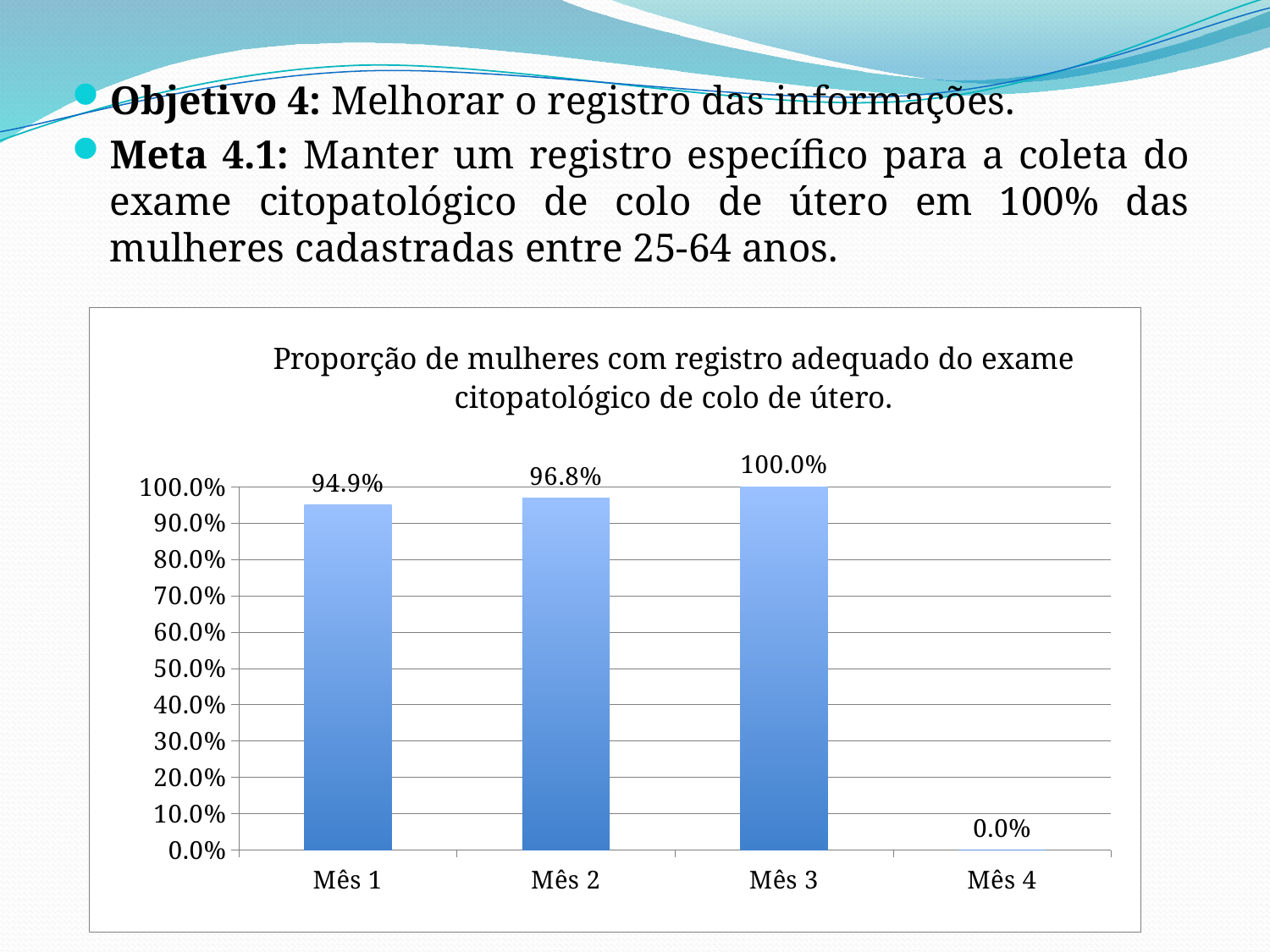
What is the difference between the values for Mês 2 and Mês 1? 1.9% What is the value for Mês 3? 100.0% What is the value for Mês 2? 96.8% Is the value for Mês 1 greater or less than 90.0%? greater Which month has the highest value? Mês 3 What is the title of the chart? Proporção de mulheres com registro adequado do exame citopatológico de colo de útero. Which month has the lowest value? Mês 4 What kind of chart is shown? bar chart Which is larger, the value for Mês 1 or the value for Mês 2? Mês 2 What is the value for Mês 4? 0.0% How many months are shown on the x axis? 4 What is the value for Mês 1? 94.9%